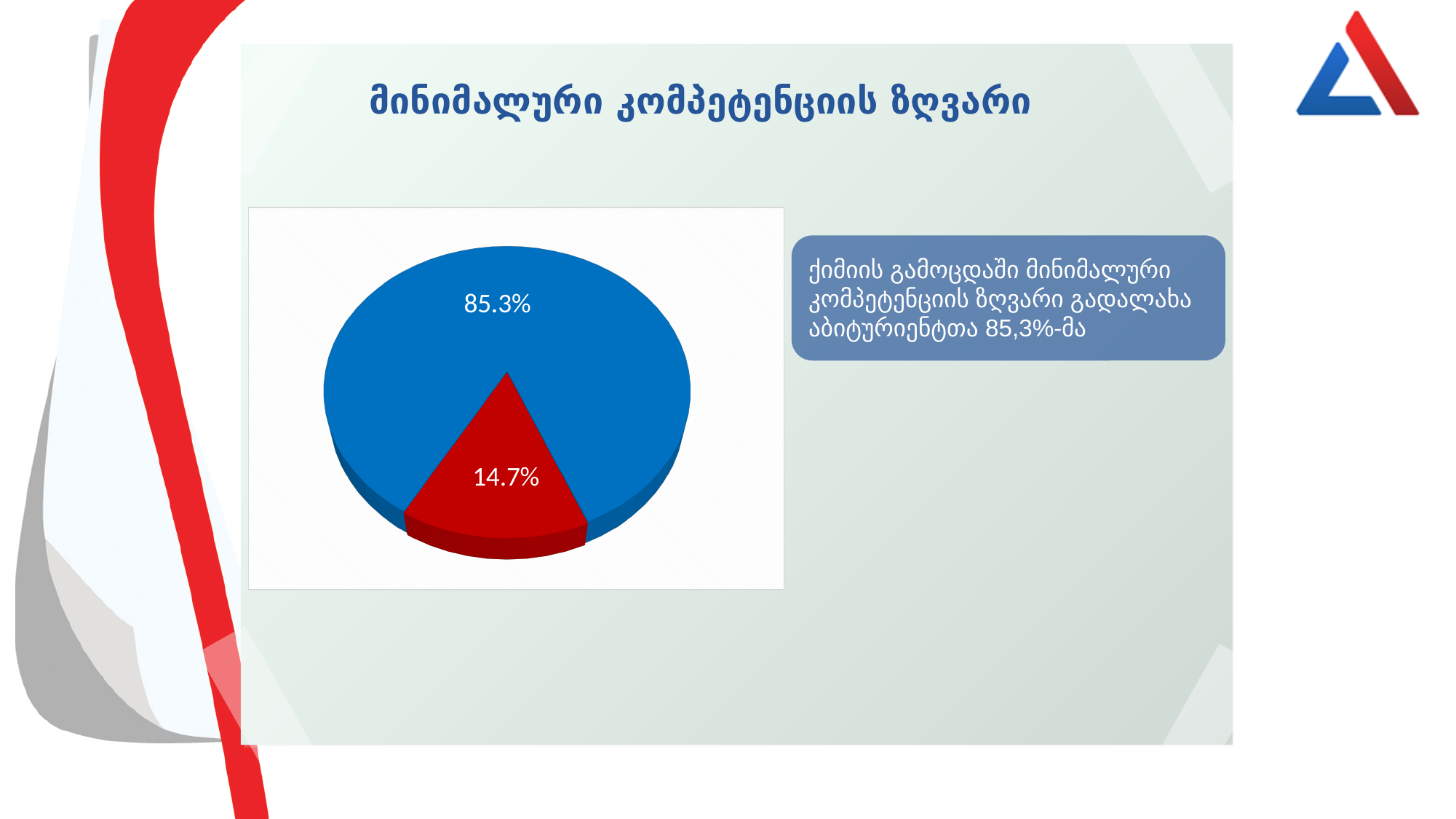
What value is shown on the blue slice of the pie chart? 85.3% Which is larger in the pie chart, the blue slice or the red slice? the blue slice What kind of chart is shown on the slide? pie chart Is the value of the blue slice greater or less than 50%? greater What colour is the slice representing 85.3% in the pie chart? blue What is the title of the slide containing the pie chart? მინიმალური კომპეტენციის ზღვარი Which slice of the pie chart is the largest? the blue slice (85.3%) What is the difference between the blue slice and the red slice of the pie chart? 70.6% How many slices does the pie chart have? 2 What share of the pie does the red slice represent? 14.7% What value is shown on the red slice of the pie chart? 14.7% Which slice of the pie chart is the smallest? the red slice (14.7%)